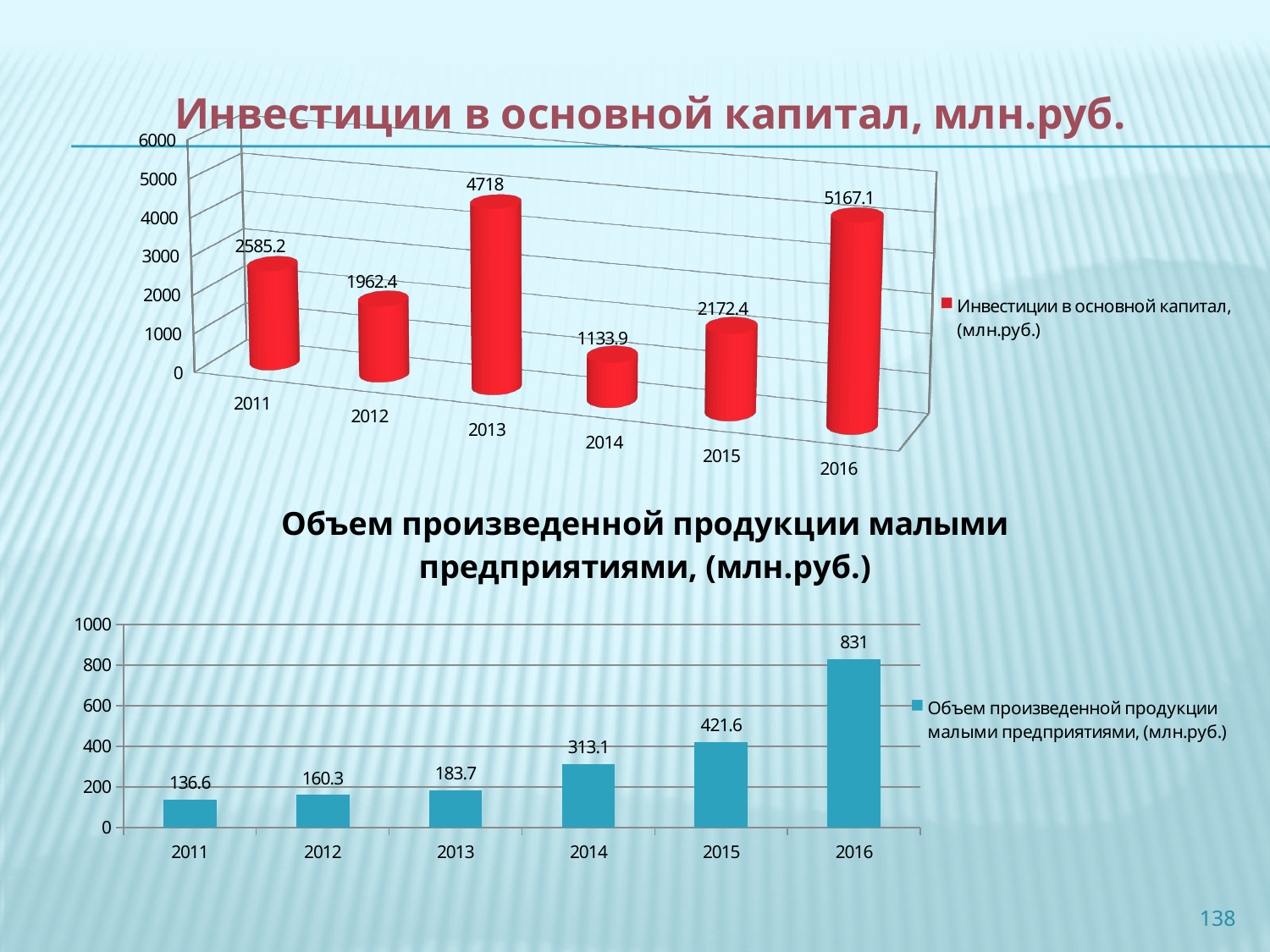
In the bottom chart 'Объем произведенной продукции малыми предприятиями, (млн.руб.)', do the values rise or fall from 2011 to 2016? rise In the top chart 'Инвестиции в основной капитал, млн.руб.', what is the difference between the values for 2016 and 2015? 2994.7 How many years are shown on the x axis of the bottom chart 'Объем произведенной продукции малыми предприятиями, (млн.руб.)'? 6 In the top chart 'Инвестиции в основной капитал, млн.руб.', what is the value for 2014? 1133.9 In the top chart 'Инвестиции в основной капитал, млн.руб.', which is larger, the value for 2011 or the value for 2012? 2011 In the top chart 'Инвестиции в основной капитал, млн.руб.', which year has the lowest value? 2014 In the top chart 'Инвестиции в основной капитал, млн.руб.', what is the value for 2013? 4718 What kind of chart is the top chart 'Инвестиции в основной капитал, млн.руб.'? bar chart In the bottom chart 'Объем произведенной продукции малыми предприятиями, (млн.руб.)', what is the value for 2015? 421.6 In the bottom chart 'Объем произведенной продукции малыми предприятиями, (млн.руб.)', what is the difference between the values for 2016 and 2015? 409.4 In the top chart 'Инвестиции в основной капитал, млн.руб.', which year has the highest value? 2016 In the bottom chart 'Объем произведенной продукции малыми предприятиями, (млн.руб.)', what is the value for 2011? 136.6